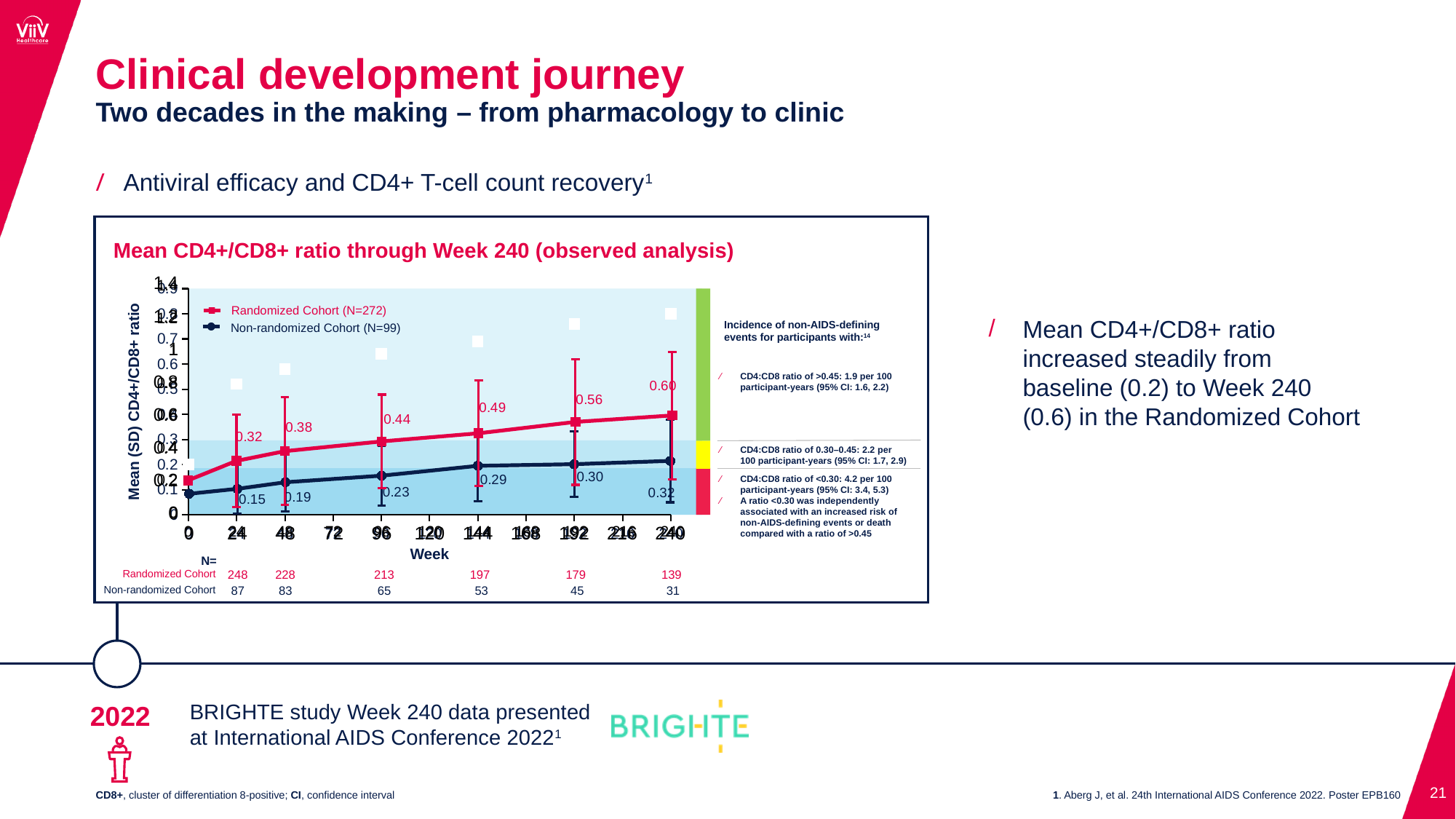
Does the Randomized Cohort's mean CD4+/CD8+ ratio rise or fall from Week 24 to Week 240? Rise How many participants (N) are in the Randomized Cohort at Week 240? 139 What kind of chart is used to show the mean CD4+/CD8+ ratio? Line chart How many series does the chart legend list? 2 What is the mean CD4+/CD8+ ratio for the Randomized Cohort at Week 240? 0.60 What is the difference between the Randomized Cohort and Non-randomized Cohort mean CD4+/CD8+ ratios at Week 192? 0.26 What is the mean CD4+/CD8+ ratio for the Randomized Cohort at Week 144? 0.49 Which cohort has the higher mean CD4+/CD8+ ratio at Week 48? Randomized Cohort What is the title of the chart? Mean CD4+/CD8+ ratio through Week 240 (observed analysis) What is the sample size (N) shown in the legend for the Non-randomized Cohort? 99 What is the mean CD4+/CD8+ ratio for the Non-randomized Cohort at Week 96? 0.23